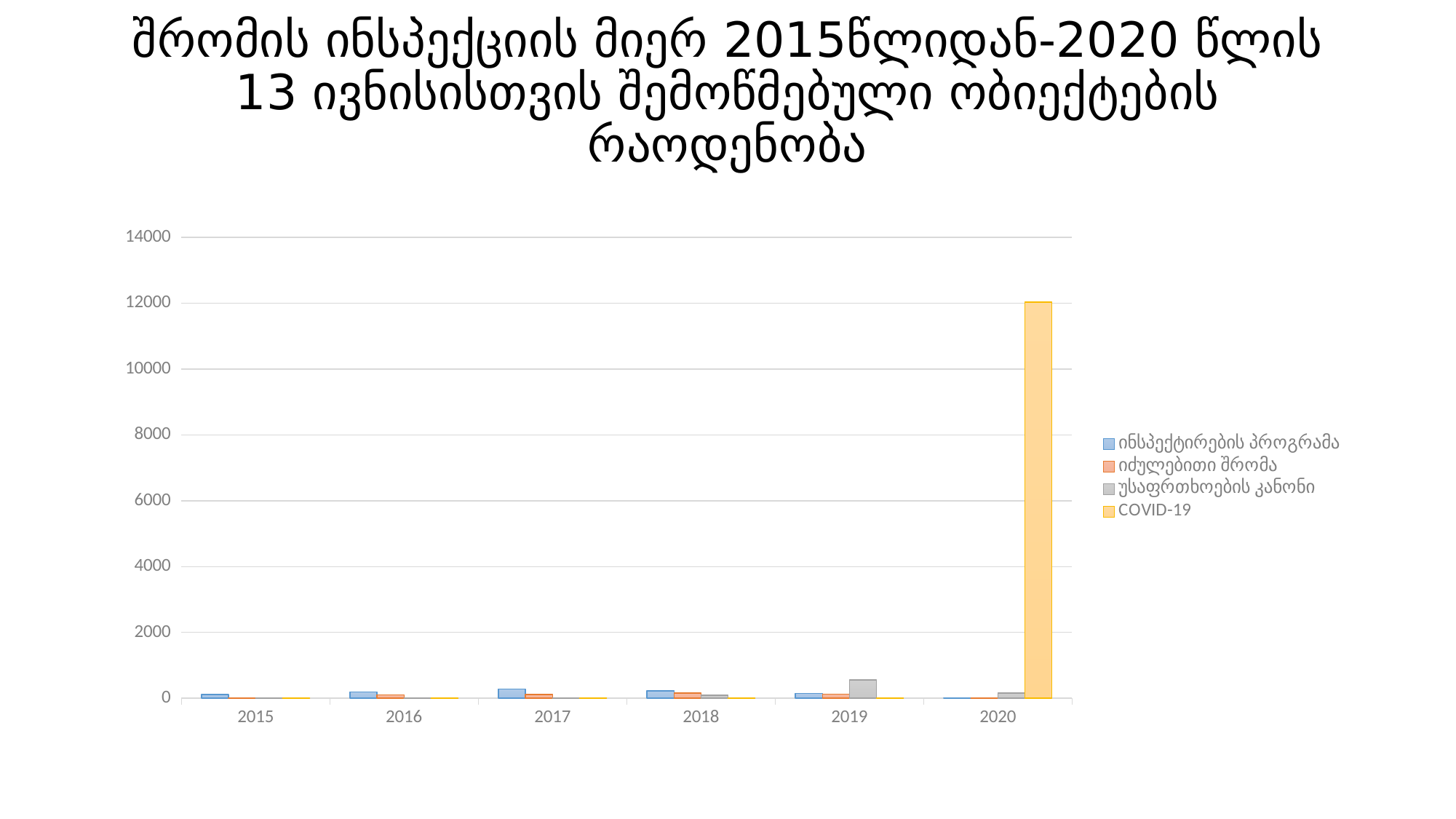
Which legend entry is shown in yellow? COVID-19 How many years are shown along the x axis of the chart? 6 How many series does the chart's legend list? 4 Is the value for უსაფრთხოების კანონი in 2019 greater or less than 2000? less In 2019, which is larger: უსაფრთხოების კანონი or ინსპექტირების პროგრამა? უსაფრთხოების კანონი What kind of chart is shown on the slide? bar chart Is the value for COVID-19 in 2020 greater or less than 10000? greater In which year does the ინსპექტირების პროგრამა series have its highest bar? 2017 In which year does the უსაფრთხოების კანონი series have its highest bar? 2019 In which year does the COVID-19 series have its highest bar? 2020 Is the value for COVID-19 in 2020 greater or less than 14000? less